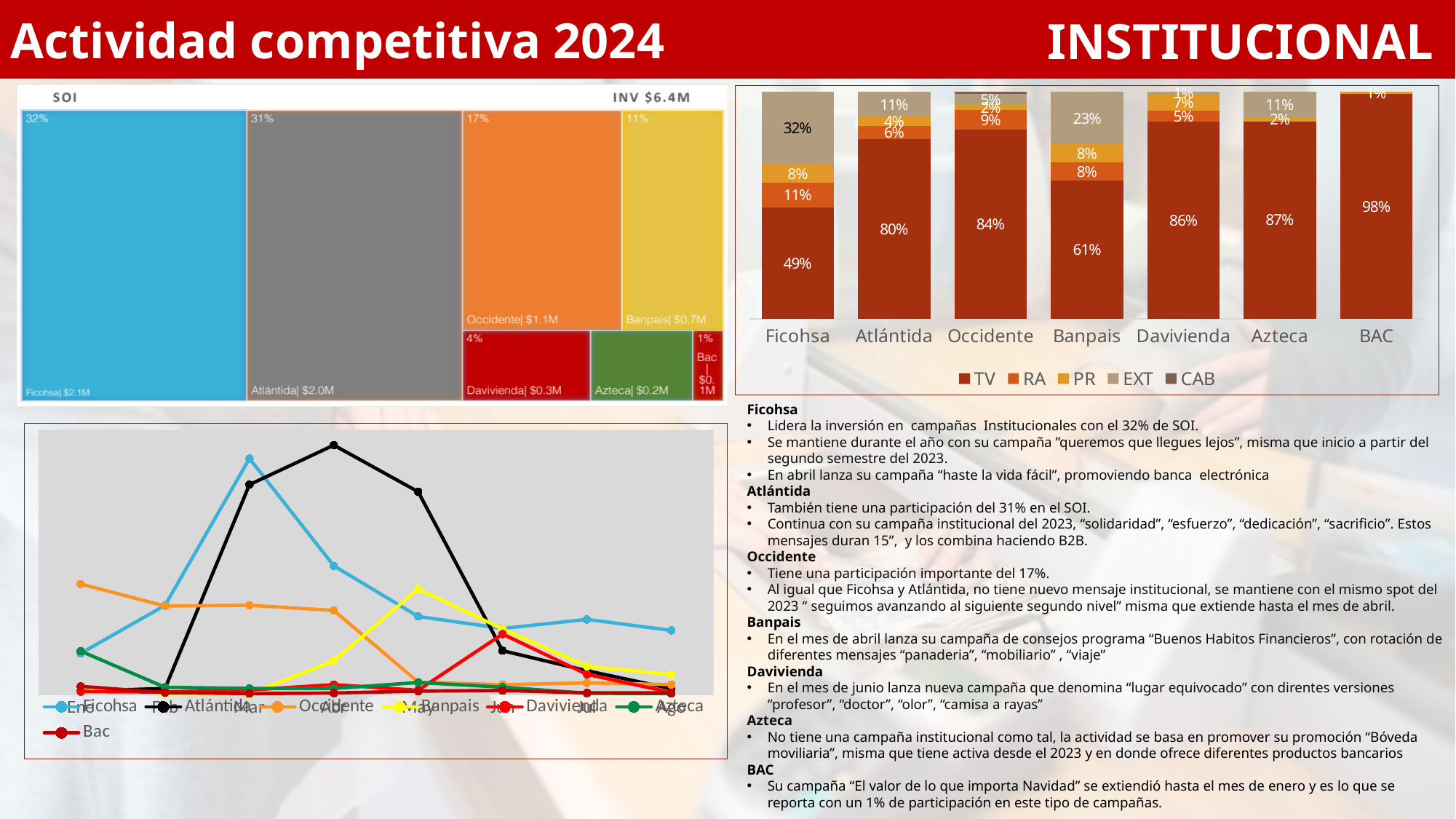
In the treemap chart on the top left, what is the difference in SOI percentage between Ficohsa and Atlántida? 1% In the stacked bar chart on the top right, which bank has the highest TV percentage? BAC In the line chart on the bottom left, how many months are shown on the x axis? 8 In the stacked bar chart on the top right, is the TV percentage for Atlántida or Occidente larger? Occidente In the stacked bar chart on the top right, what is the TV percentage for Banpais? 61% In the stacked bar chart on the top right, what is the EXT percentage for Ficohsa? 32% In the treemap chart on the top left, what investment amount is shown for Occidente? $1.1M In the line chart on the bottom left, which bank reaches the highest peak, and in which month? Atlántida, Abr In the stacked bar chart on the top right, how many series does the legend list? 5 In the treemap chart on the top left, which bank has the smallest share of SOI? Bac In the treemap chart on the top left, what is the total investment (INV) shown in the header? $6.4M In the treemap chart on the top left, what is the SOI percentage shown for Ficohsa? 32%